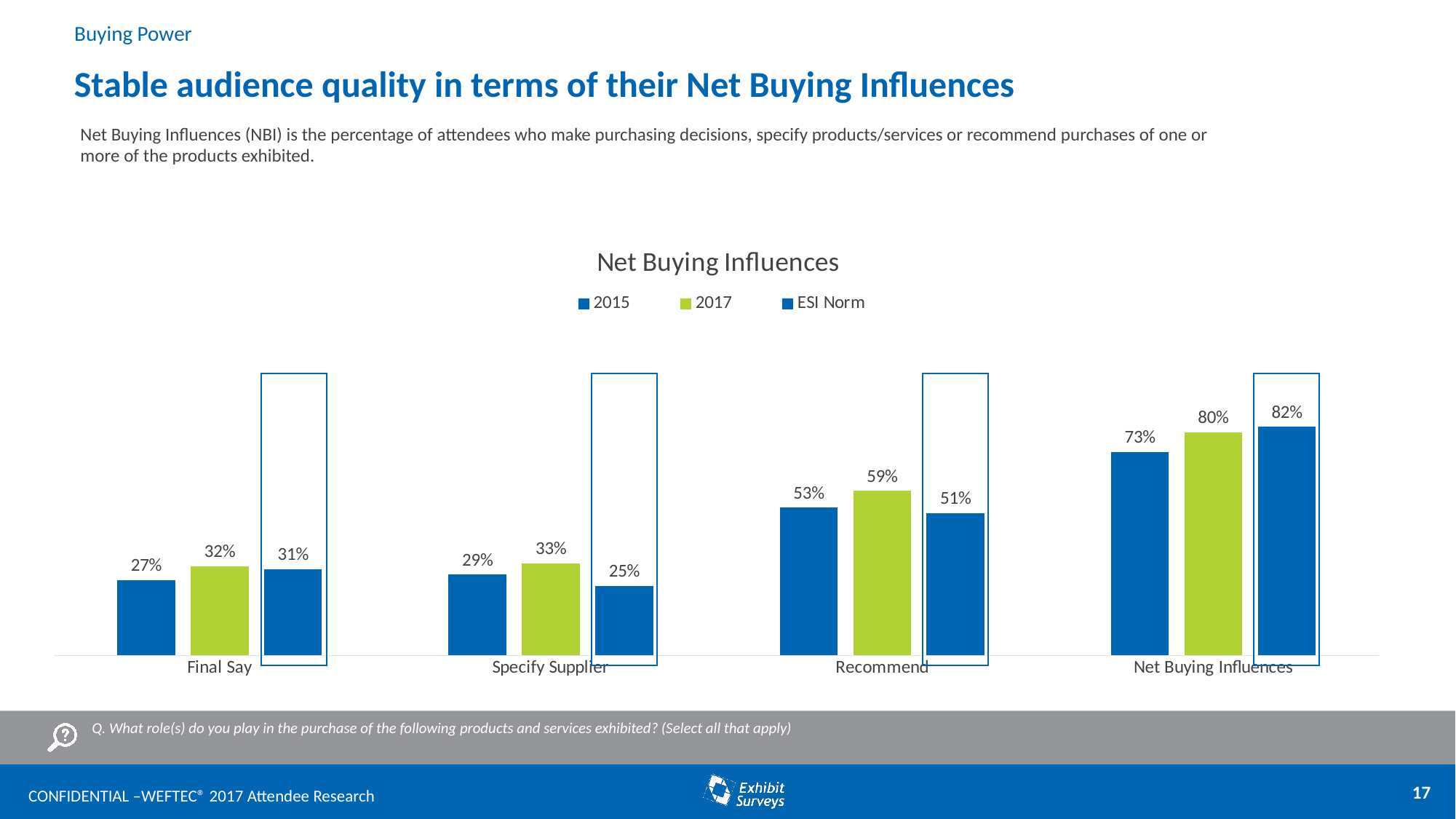
For Recommend, which is larger: the 2017 value or the ESI Norm value? 2017 What kind of chart is shown? Bar chart What is the 2015 value for Net Buying Influences? 73% What is the title of the chart? Net Buying Influences How many categories are shown on the x axis? 4 What is the difference between the 2017 and 2015 values for Net Buying Influences? 7% What is the ESI Norm value for Specify Supplier? 25% Which category has the highest 2017 value? Net Buying Influences How many series does the legend list? 3 What is the difference between the 2017 and ESI Norm values for Specify Supplier? 8% What is the 2017 value for Recommend? 59% Which category has the lowest 2015 value? Final Say